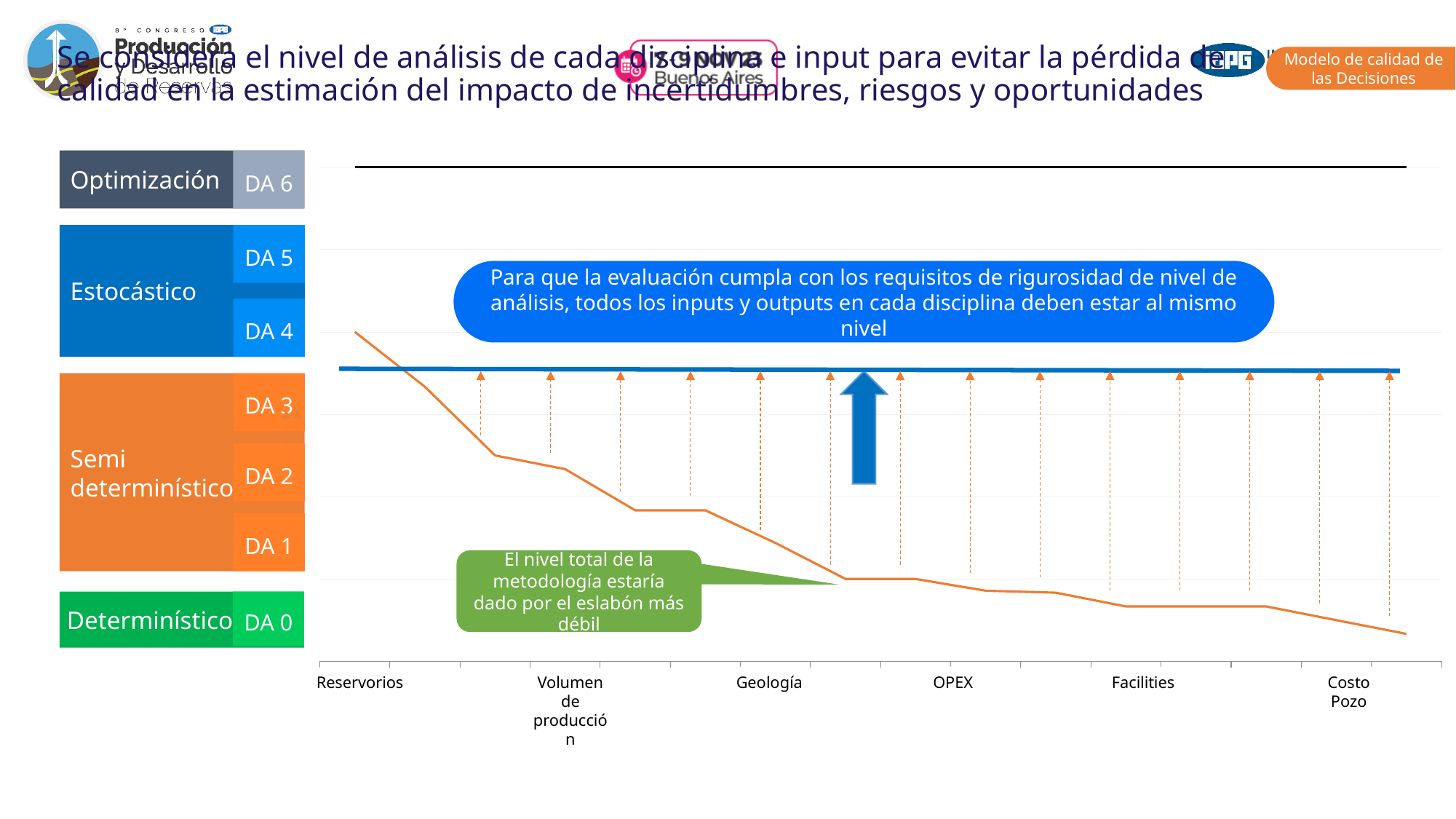
On the orange line, which is higher: Reservorios or Geología? Reservorios Which x-axis category has the lowest value on the orange line? Costo Pozo How many categories are labelled on the x axis of the chart? 6 What colour is the horizontal line drawn across the chart above the stepped line? blue What kind of chart is shown on the slide? line chart On the orange line, which is higher: Facilities or Costo Pozo? Facilities What does the green callout on the chart say? El nivel total de la metodología estaría dado por el eslabón más débil Which x-axis category has the highest value on the orange line? Reservorios Does the orange line rise or fall as it moves from Reservorios to Costo Pozo along the x axis? fall On the orange line, which is higher: Geología or OPEX? Geología